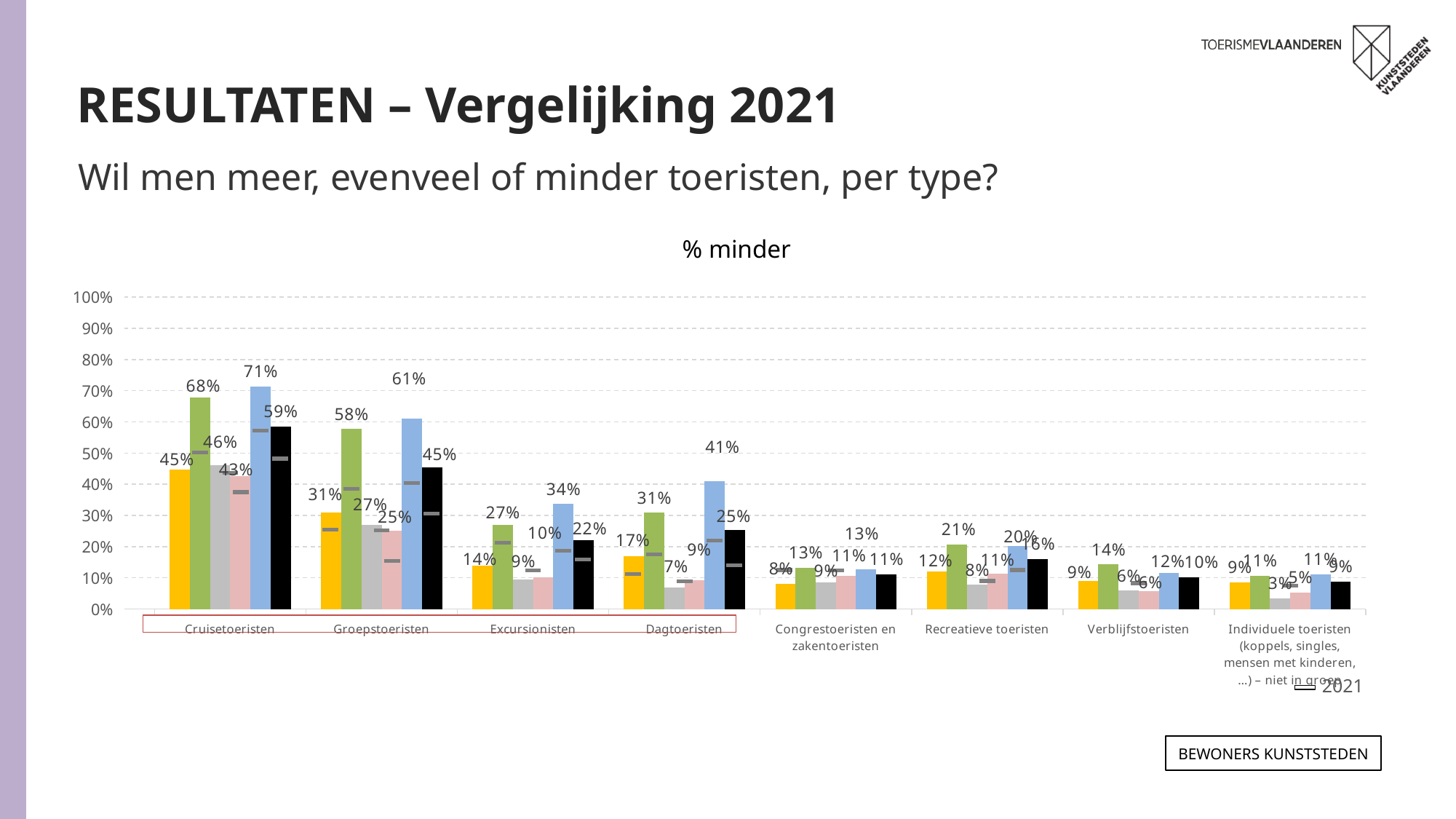
How many tourist-type categories are shown along the x axis? 8 Which group has the taller maximum bar: Excursionisten or Dagtoeristen? Dagtoeristen What is the lowest value labelled in the Individuele toeristen group? 3% What is the highest value labelled anywhere on the chart? 71% Is the tallest bar for Verblijfstoeristen greater or less than 20%? less What is the title of the chart? % minder Do the values generally rise or fall moving from left to right across the categories? fall What is the difference between the tallest bar for Cruisetoeristen (71%) and the tallest bar for Groepstoeristen (61%)? 10 percentage points What kind of chart is shown on the slide? bar chart Which category contains the tallest bar on the chart? Cruisetoeristen What is the value of the tallest bar in the Groepstoeristen group? 61% What is the value of the yellow (first) bar for Cruisetoeristen? 45%